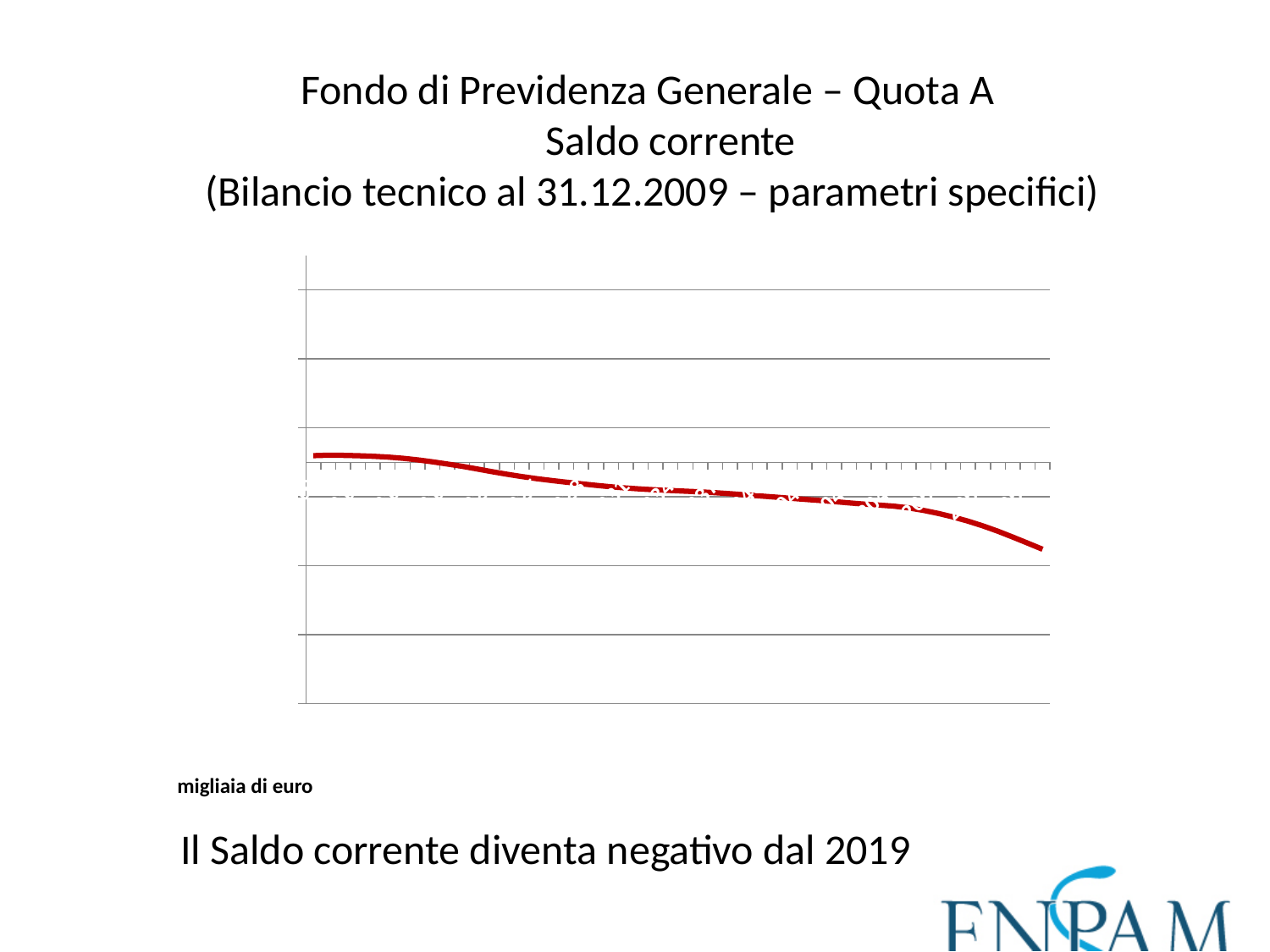
What kind of chart is shown on the slide? line chart In what unit are the chart's values expressed, according to the note below the chart? migliaia di euro Do the values of the plotted line rise or fall from left to right along the x axis? fall What colour is the line plotted on the chart? red